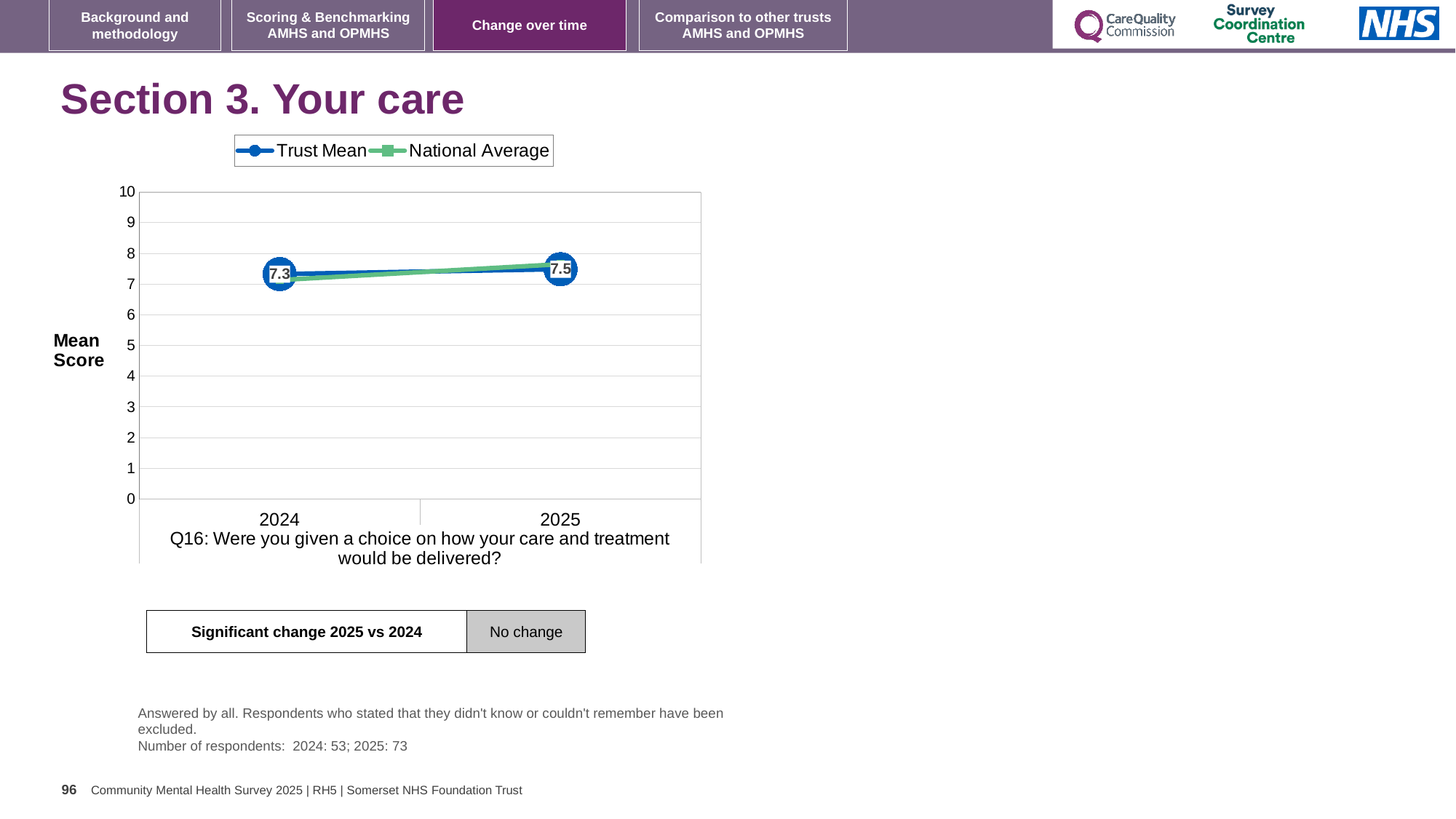
What is the Trust Mean value for 2024? 7.3 Which series is shown in green in the legend? National Average Is the National Average value for 2025 greater or less than 6? greater What is the label on the y axis of the chart? Mean Score Does the Trust Mean rise or fall from 2024 to 2025? rise What is the difference between the Trust Mean for 2025 and the Trust Mean for 2024? 0.2 Which year has the higher Trust Mean, 2024 or 2025? 2025 Is the Trust Mean value for 2024 greater or less than 5? greater What is the Trust Mean value for 2025? 7.5 How many years are plotted on the x axis? 2 What kind of chart is shown on the slide? line chart How many series does the legend list? 2